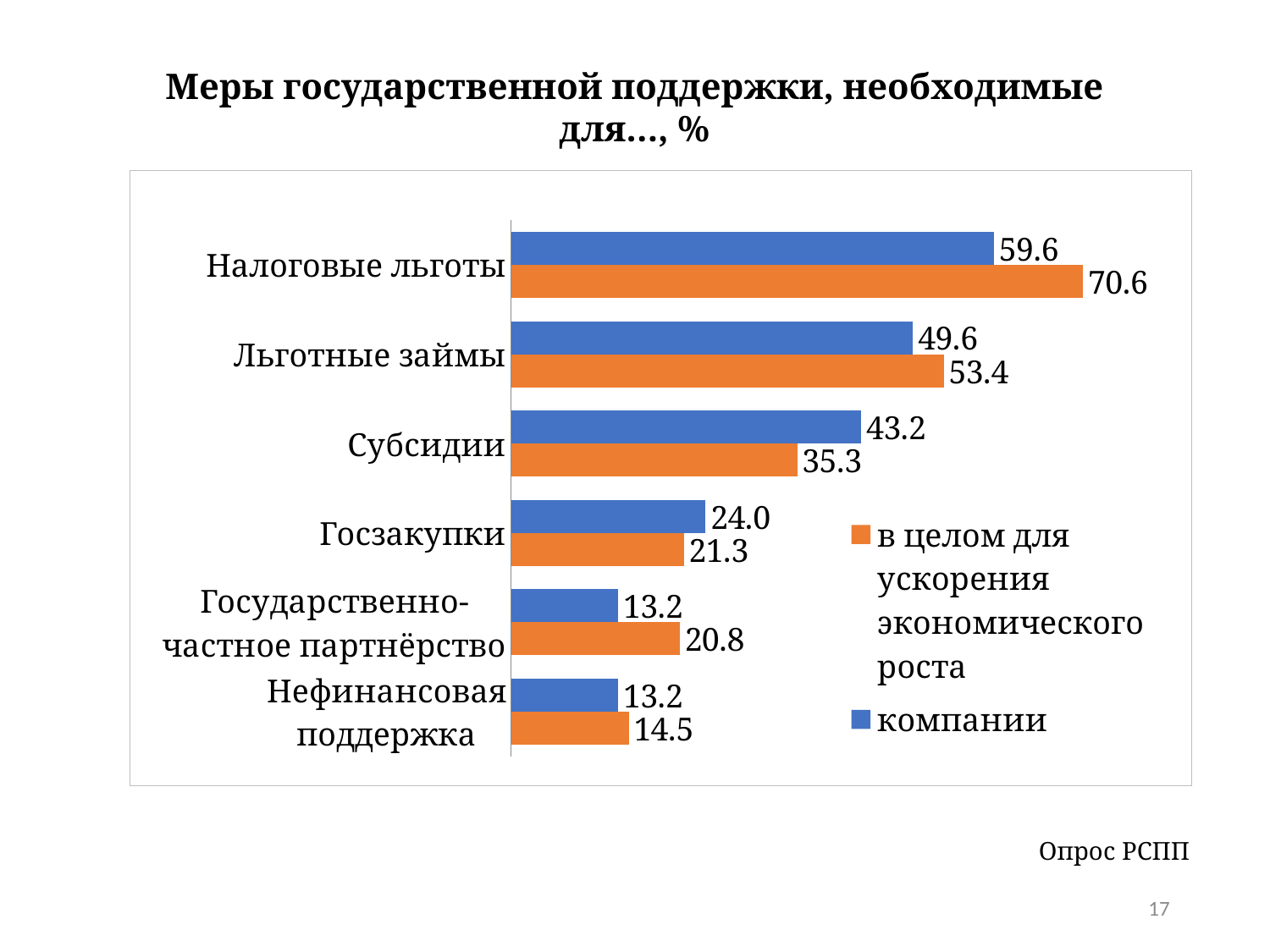
What is the value for «Налоговые льготы» in the «компании» series? 59.6 How many series does the legend list? 2 What is the value for «Госзакупки» in the «компании» series? 24.0 What is the difference between the «в целом для ускорения экономического роста» and «компании» values for «Налоговые льготы»? 11.0 What kind of chart is shown on the slide? Bar chart For «Государственно-частное партнёрство», which series has the larger value: «компании» or «в целом для ускорения экономического роста»? в целом для ускорения экономического роста What colour are the bars for the «компании» series? Blue For «Субсидии», which series has the larger value: «компании» or «в целом для ускорения экономического роста»? компании What is the value for «Субсидии» in the «в целом для ускорения экономического роста» series? 35.3 Which category has the lowest value in the «в целом для ускорения экономического роста» series? Нефинансовая поддержка How many categories are shown in the chart? 6 Which category has the highest value in the «в целом для ускорения экономического роста» series? Налоговые льготы